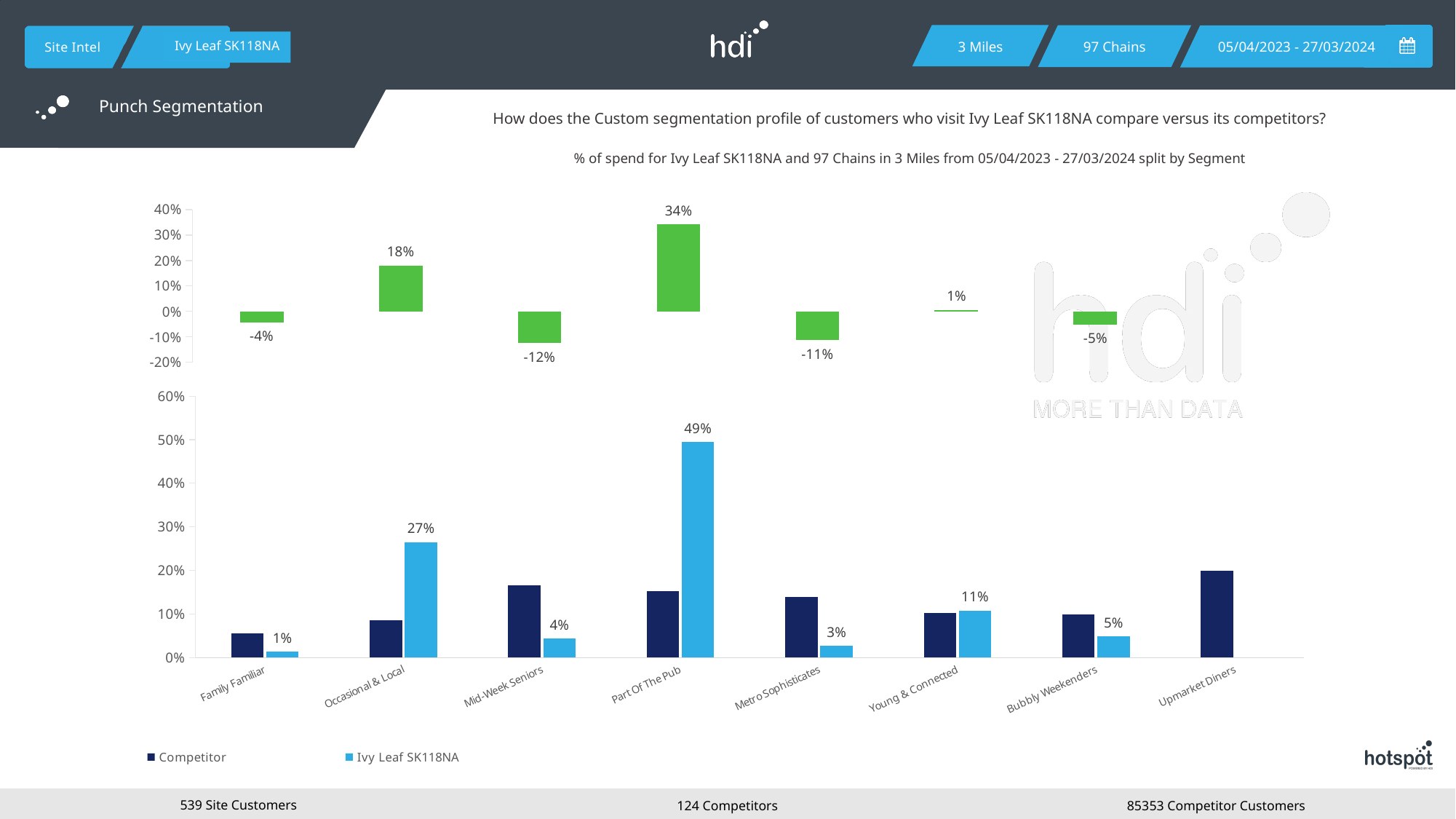
In the bottom chart, what is the Ivy Leaf SK118NA value for Young & Connected? 11% In the bottom chart, what is the difference between the Ivy Leaf SK118NA values for Part Of The Pub and Occasional & Local? 22 percentage points In the bottom chart, how many series does the legend list? 2 In the bottom chart, what is the Ivy Leaf SK118NA value for Part Of The Pub? 49% In the bottom chart, is the Competitor value for Family Familiar greater or less than 10%? less In the bottom chart, is the Competitor value for Upmarket Diners greater or less than 10%? greater How many segment categories are shown on the x axis of the bottom chart? 8 In the top chart, what is the value shown for Part Of The Pub? 34% In the top chart, what is the value shown for Occasional & Local? 18% In the bottom chart, for Part Of The Pub, which series has the larger value: Competitor or Ivy Leaf SK118NA? Ivy Leaf SK118NA In the top chart, which segment has the lowest labelled value? Mid-Week Seniors In the top chart, which segment has the highest value? Part Of The Pub